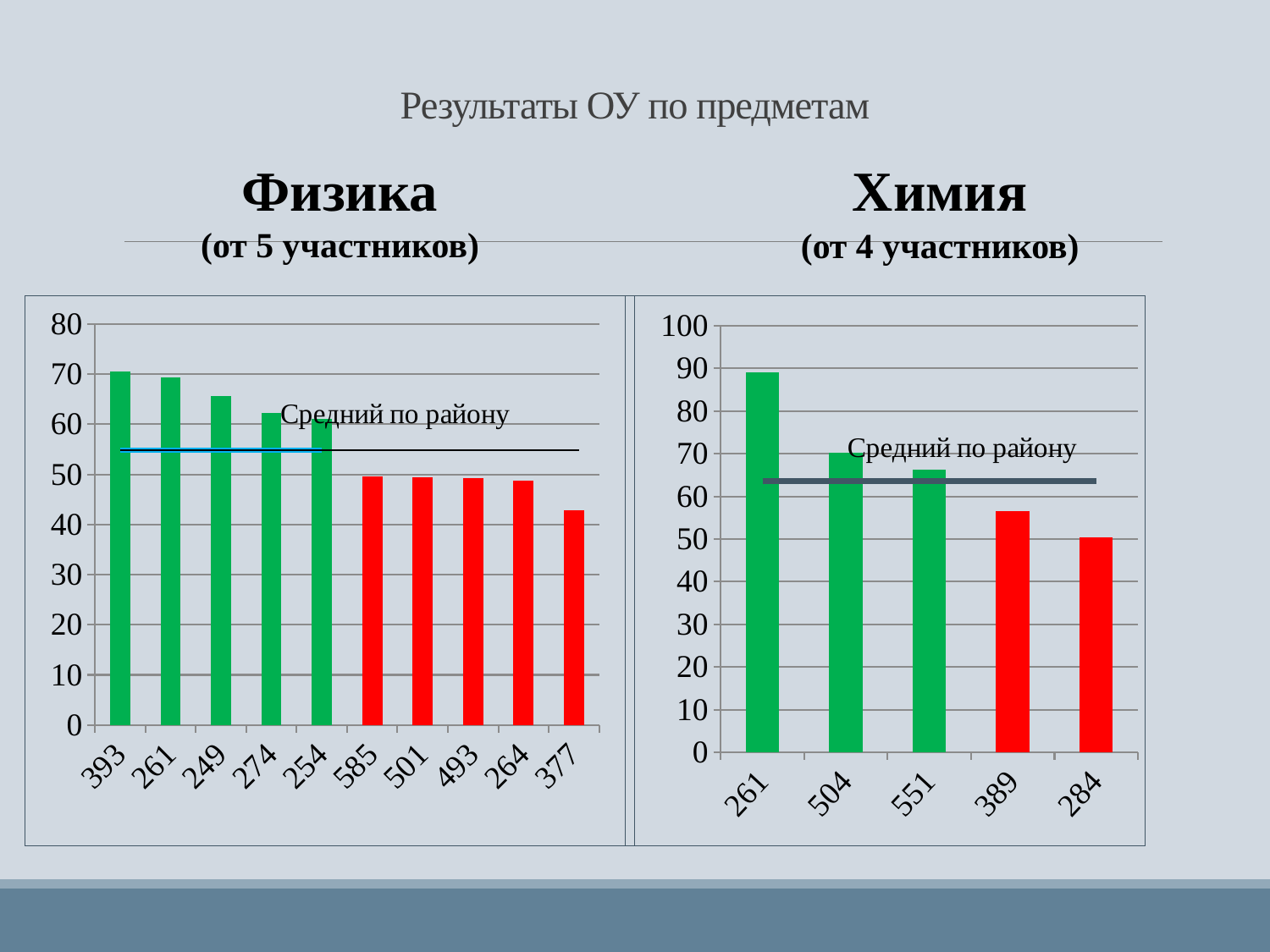
On the Химия chart, is the value for 261 greater or less than 80? greater On the Химия chart, which is larger, the value for 504 or the value for 389? 504 On the Физика chart, how many categories are shown on the x axis? 10 On the Физика chart, which category has the lowest value? 377 What kind of chart is the Химия chart? bar chart On the Химия chart, which category has the highest value? 261 On the Физика chart, is the value for 393 greater or less than 60? greater On the Физика chart, do the values rise or fall from left to right along the x axis? fall On the Физика chart, is the value for 377 greater or less than 50? less On the Химия chart, which category has the lowest value? 284 On the Химия chart, how many bars are plotted? 5